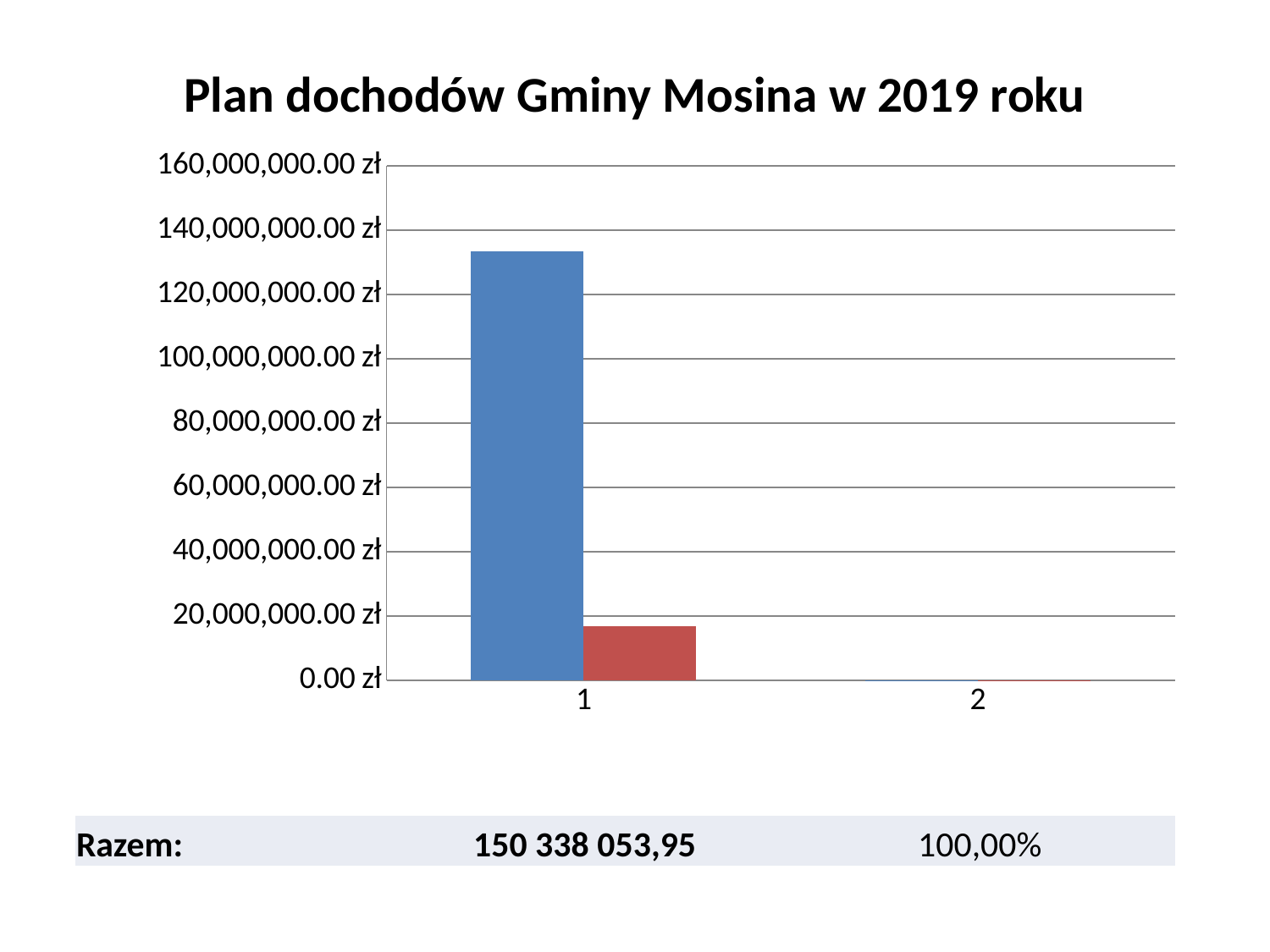
For category 1, which bar is larger, the blue one or the red one? the blue one How many bars are plotted for category 1? 2 How many categories are shown on the x axis of the chart? 2 What is the title of the chart? Plan dochodów Gminy Mosina w 2019 roku Is the value of the blue bar for category 1 greater or less than 120,000,000.00 zł? greater Is the value of the blue bar for category 1 greater or less than 140,000,000.00 zł? less Which category has the tallest bar in the chart? 1 Is the value of the red bar for category 1 greater or less than 20,000,000.00 zł? less Do the values rise or fall from category 1 to category 2? fall Which category has the lowest values in the chart? 2 What kind of chart is shown on the slide? bar chart